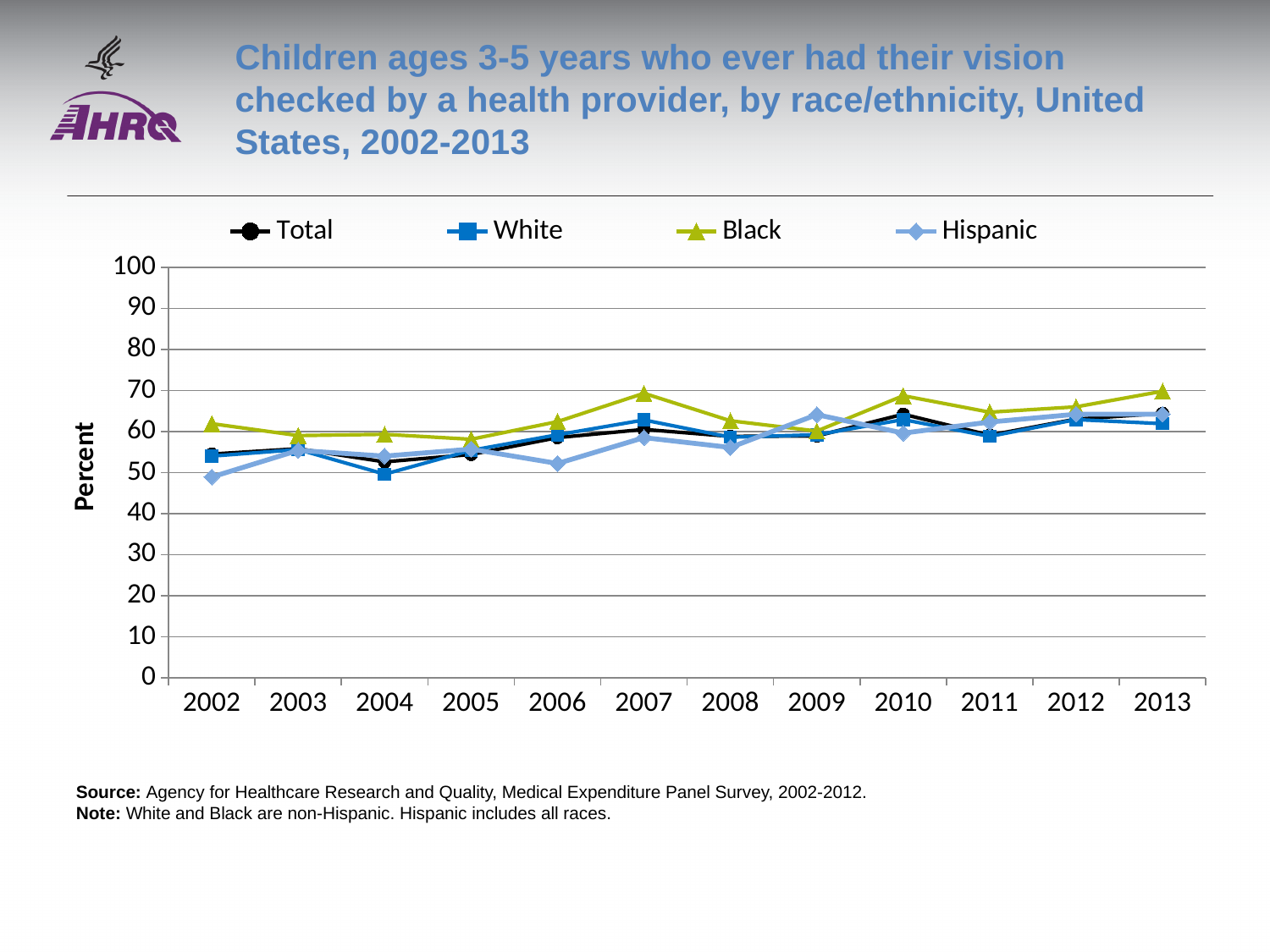
How many series does the legend list? 4 How many years are plotted along the x axis? 12 Is the value for Hispanic in 2006 greater or less than 60? less Is the value for Black in 2007 greater or less than 60? greater Does the Total series rise or fall overall from 2002 to 2013? rise Is the value for Total in 2010 greater or less than 60? greater Which series has the highest value in 2007? Black In 2002, which is larger, the value for Black or the value for Hispanic? Black What is the label on the y axis? Percent Which series has the lowest value in 2002? Hispanic What kind of chart is shown on the slide? line chart